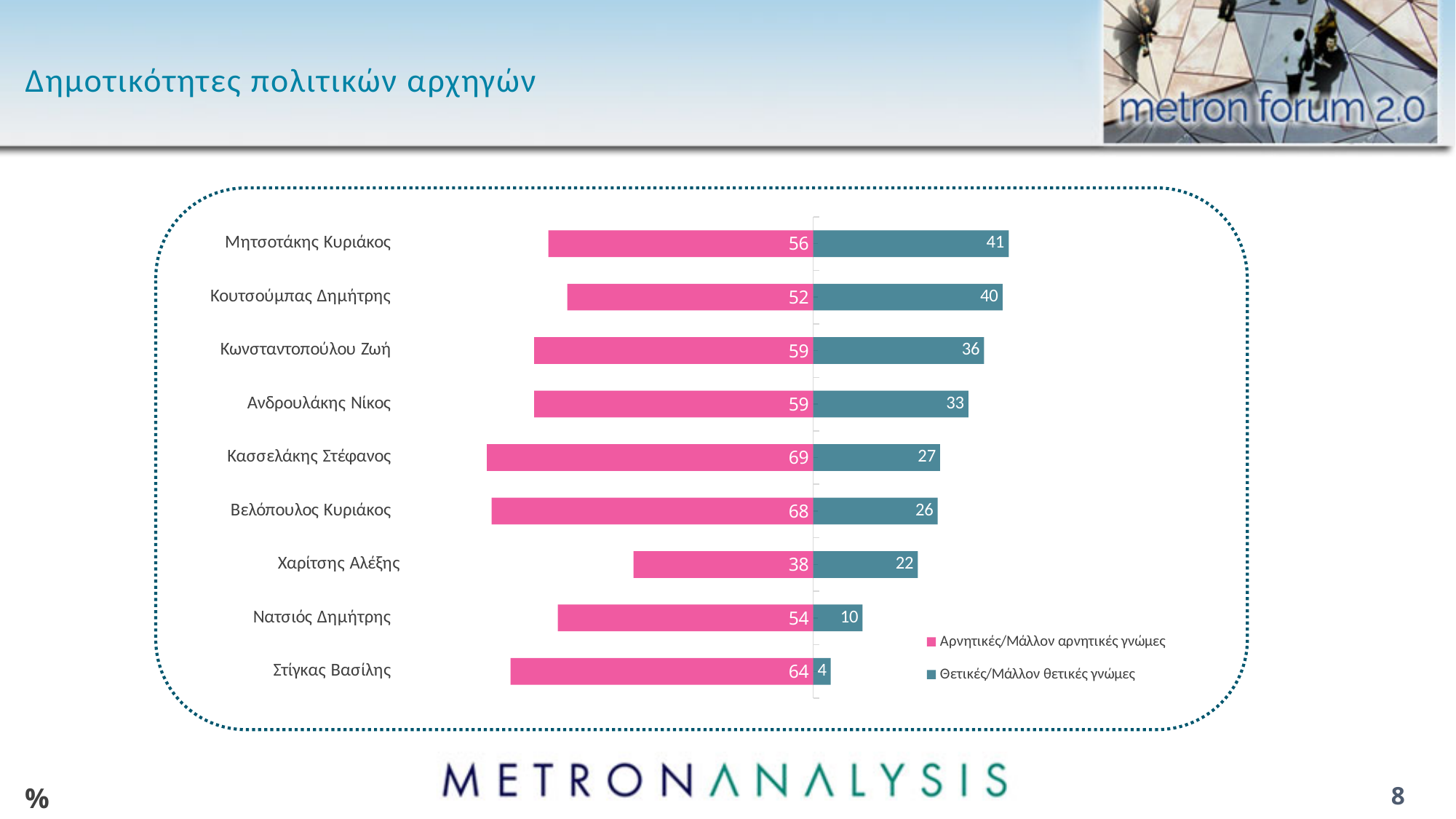
How many series does the legend list? 2 What is the value of Θετικές/Μάλλον θετικές γνώμες for Μητσοτάκης Κυριάκος? 41 What is the difference between the Αρνητικές/Μάλλον αρνητικές γνώμες and Θετικές/Μάλλον θετικές γνώμες values for Κουτσούμπας Δημήτρης? 12 Which leader has the lowest value for Αρνητικές/Μάλλον αρνητικές γνώμες? Χαρίτσης Αλέξης What kind of chart is shown on the slide? Bar chart How many political leaders are shown in the chart? 9 Which is larger: the Θετικές/Μάλλον θετικές γνώμες value for Ανδρουλάκης Νίκος or for Βελόπουλος Κυριάκος? Ανδρουλάκης Νίκος What is the value of Αρνητικές/Μάλλον αρνητικές γνώμες for Κασσελάκης Στέφανος? 69 What is the title of the slide? Δημοτικότητες πολιτικών αρχηγών What is the value of Θετικές/Μάλλον θετικές γνώμες for Στίγκας Βασίλης? 4 Which leader has the highest value for Θετικές/Μάλλον θετικές γνώμες? Μητσοτάκης Κυριάκος Which colour represents Αρνητικές/Μάλλον αρνητικές γνώμες in the chart? Pink